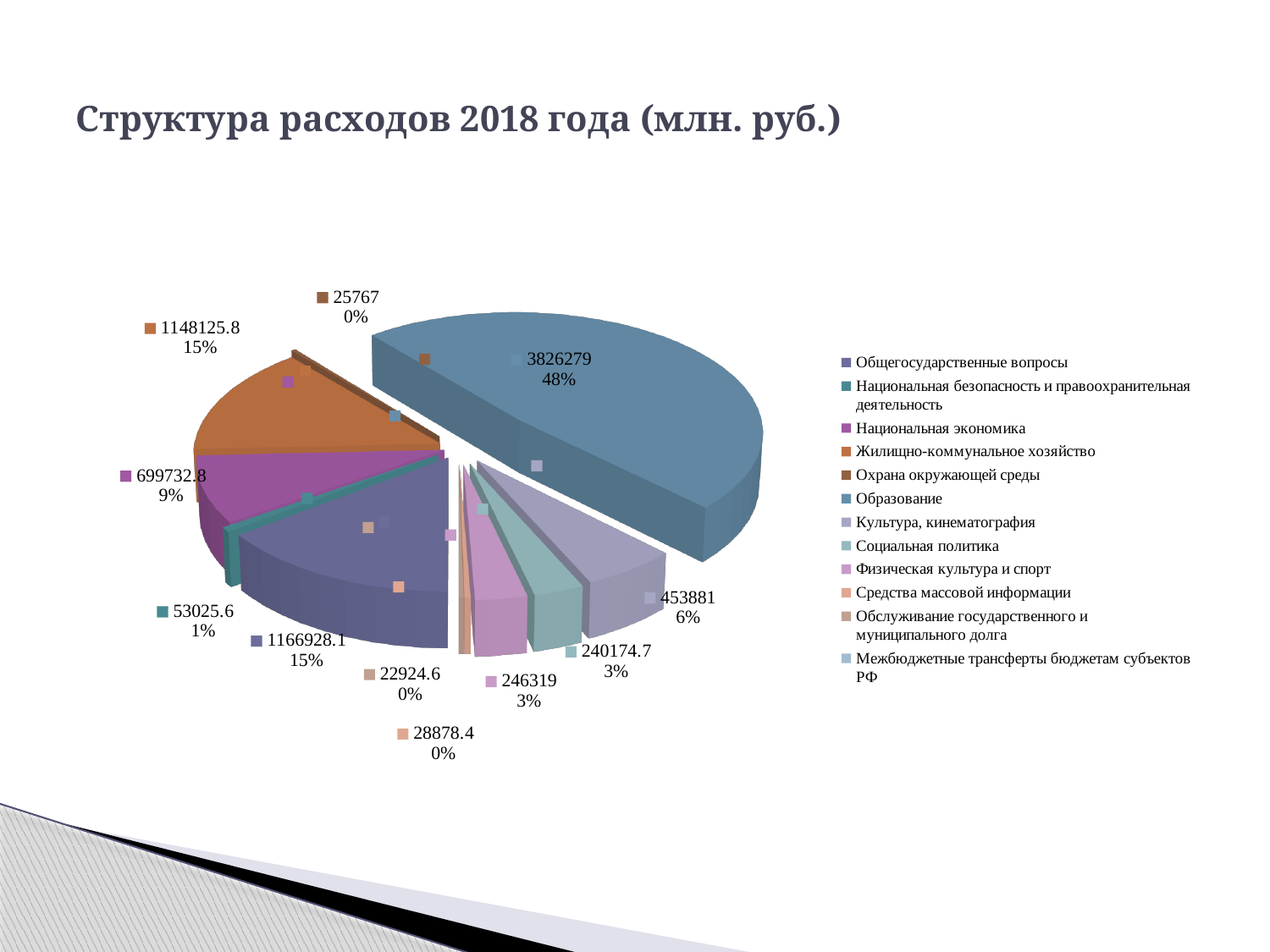
What is the title of the chart? Структура расходов 2018 года (млн. руб.) What is the value for Образование? 3826279 Which is larger, the value for Общегосударственные вопросы or the value for Жилищно-коммунальное хозяйство? Общегосударственные вопросы Which category has the largest slice of the pie? Образование What is the value for Жилищно-коммунальное хозяйство? 1148125.8 What share of the pie does Культура, кинематография take? 6% How many entries does the chart legend list? 12 What is the value for Национальная безопасность и правоохранительная деятельность? 53025.6 What is the difference between the value for Физическая культура и спорт and the value for Социальная политика? 6144.3 What kind of chart is shown on the slide? pie chart What share of the pie does Образование take? 48% What is the value for Национальная экономика? 699732.8